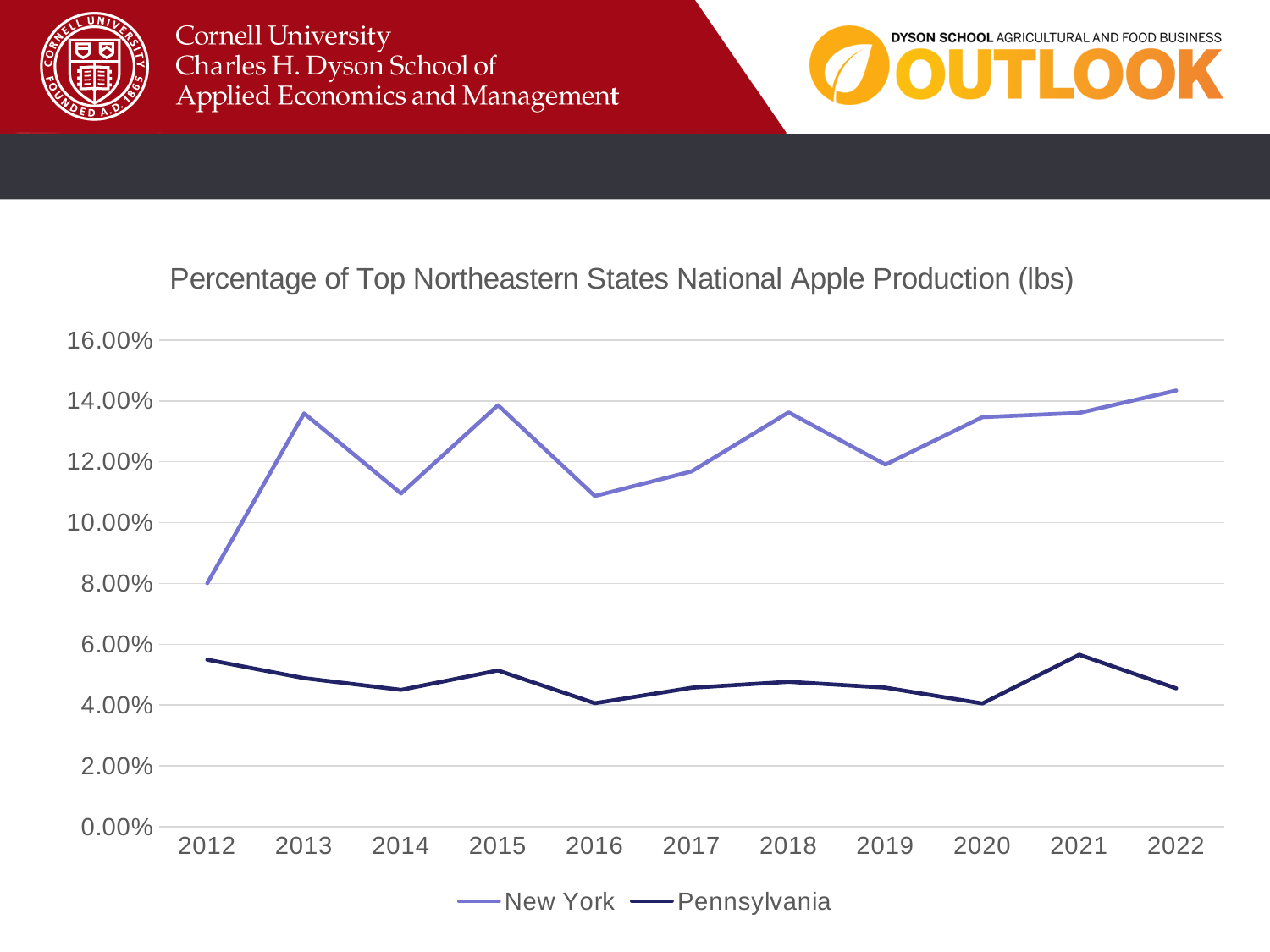
In which year is the New York value highest? 2022 What is the title of the chart? Percentage of Top Northeastern States National Apple Production (lbs) Is the New York value for 2012 greater or less than 10.00%? less Is the Pennsylvania value for 2021 greater or less than 4.00%? greater Is the Pennsylvania value for 2012 greater or less than 6.00%? less Does the New York line rise or fall from 2019 to 2022? Rise How many years are shown on the x axis? 11 How many series does the legend list? 2 Which series has the larger value in 2018, New York or Pennsylvania? New York What type of chart is shown on the slide? Line chart In which year is the New York value lowest? 2012